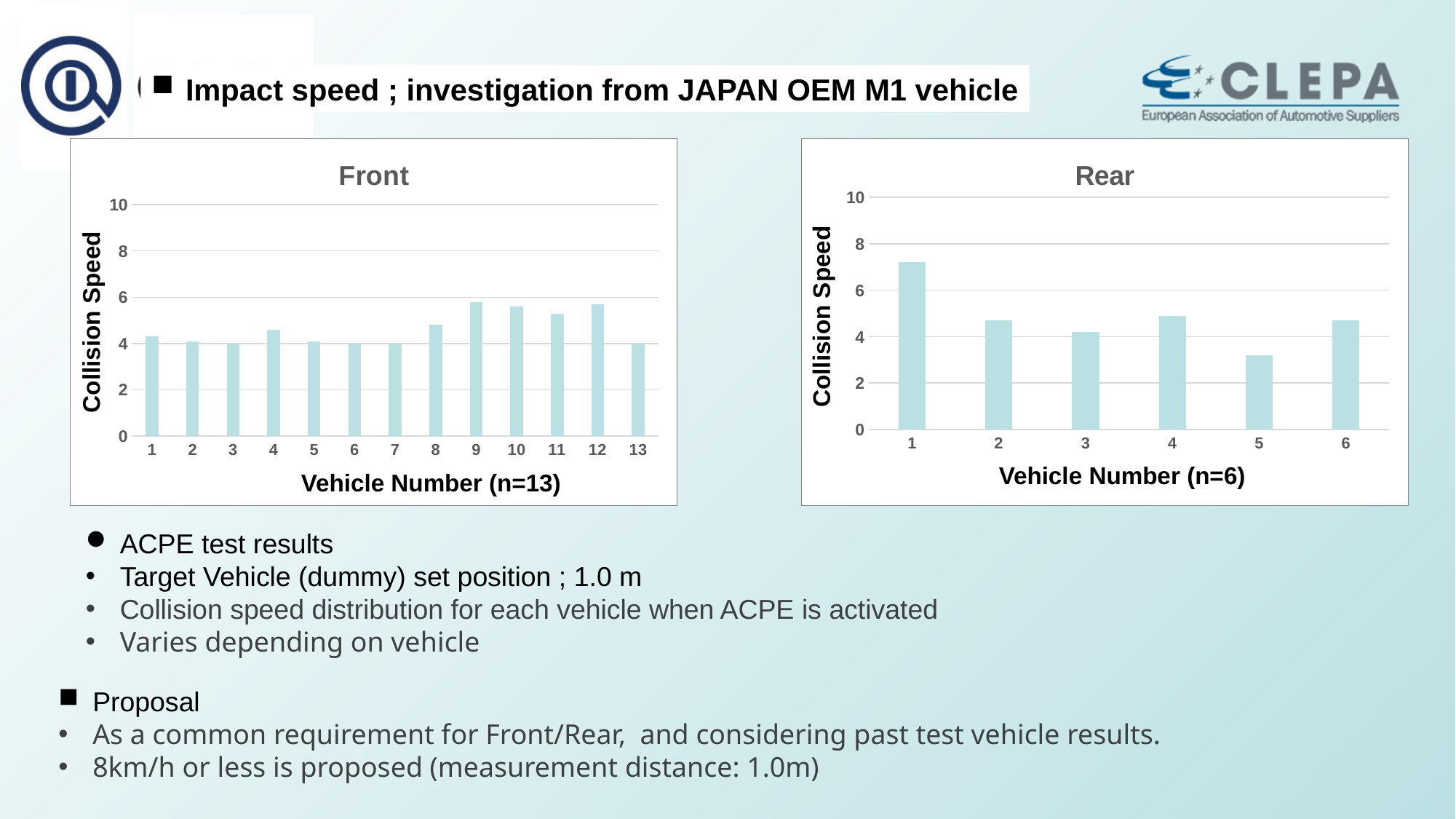
In the Rear chart, which has the higher collision speed, vehicle 1 or vehicle 5? vehicle 1 In the Front chart, is the collision speed for vehicle 1 greater or less than 6? less In the Front chart, which has the higher collision speed, vehicle 3 or vehicle 9? vehicle 9 In the Rear chart, which vehicle number has the highest collision speed? 1 What is the y-axis title of the Front chart? Collision Speed How many vehicles are plotted in the Rear chart? 6 In the Rear chart, is the collision speed for vehicle 1 greater or less than 6? greater What type of chart is the Front chart? bar chart In the Rear chart, is the collision speed for vehicle 5 greater or less than 4? less How many vehicles are plotted in the Front chart? 13 In the Rear chart, which vehicle number has the lowest collision speed? 5